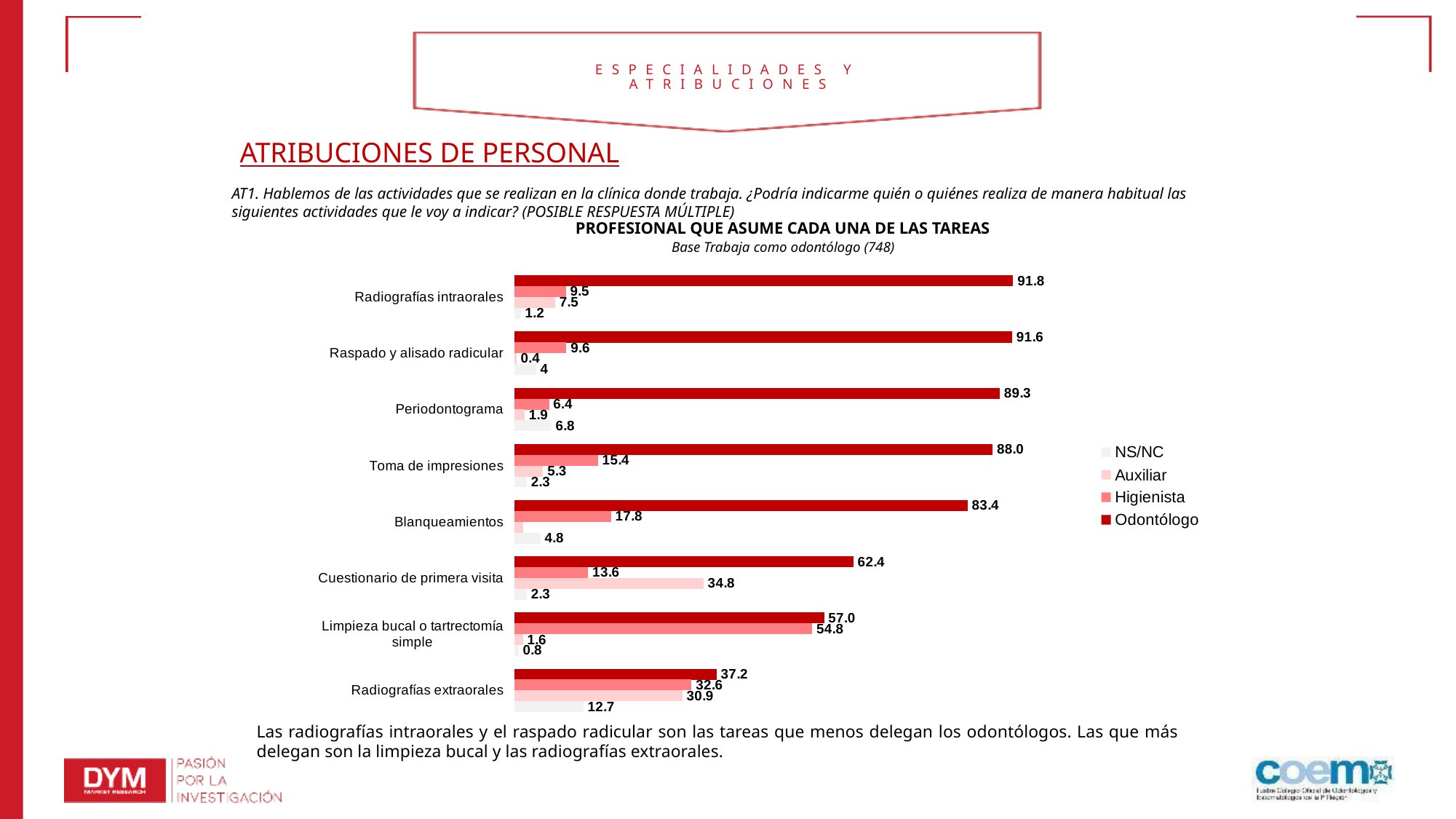
What is the Auxiliar value for Cuestionario de primera visita? 34.8 Which category has the highest Odontólogo value? Radiografías intraorales What kind of chart is shown on the slide? Bar chart What is the Higienista value for Limpieza bucal o tartrectomía simple? 54.8 How many series does the legend list? 4 What is the base stated under the chart title? Base Trabaja como odontólogo (748) What is the difference between the Odontólogo and Higienista values for Limpieza bucal o tartrectomía simple? 2.2 What is the Odontólogo value for Radiografías intraorales? 91.8 How many categories (tasks) are shown on the chart? 8 Which category has the lowest Odontólogo value? Radiografías extraorales What is the NS/NC value for Radiografías extraorales? 12.7 Which is larger for Blanqueamientos: the Higienista value or the NS/NC value? Higienista